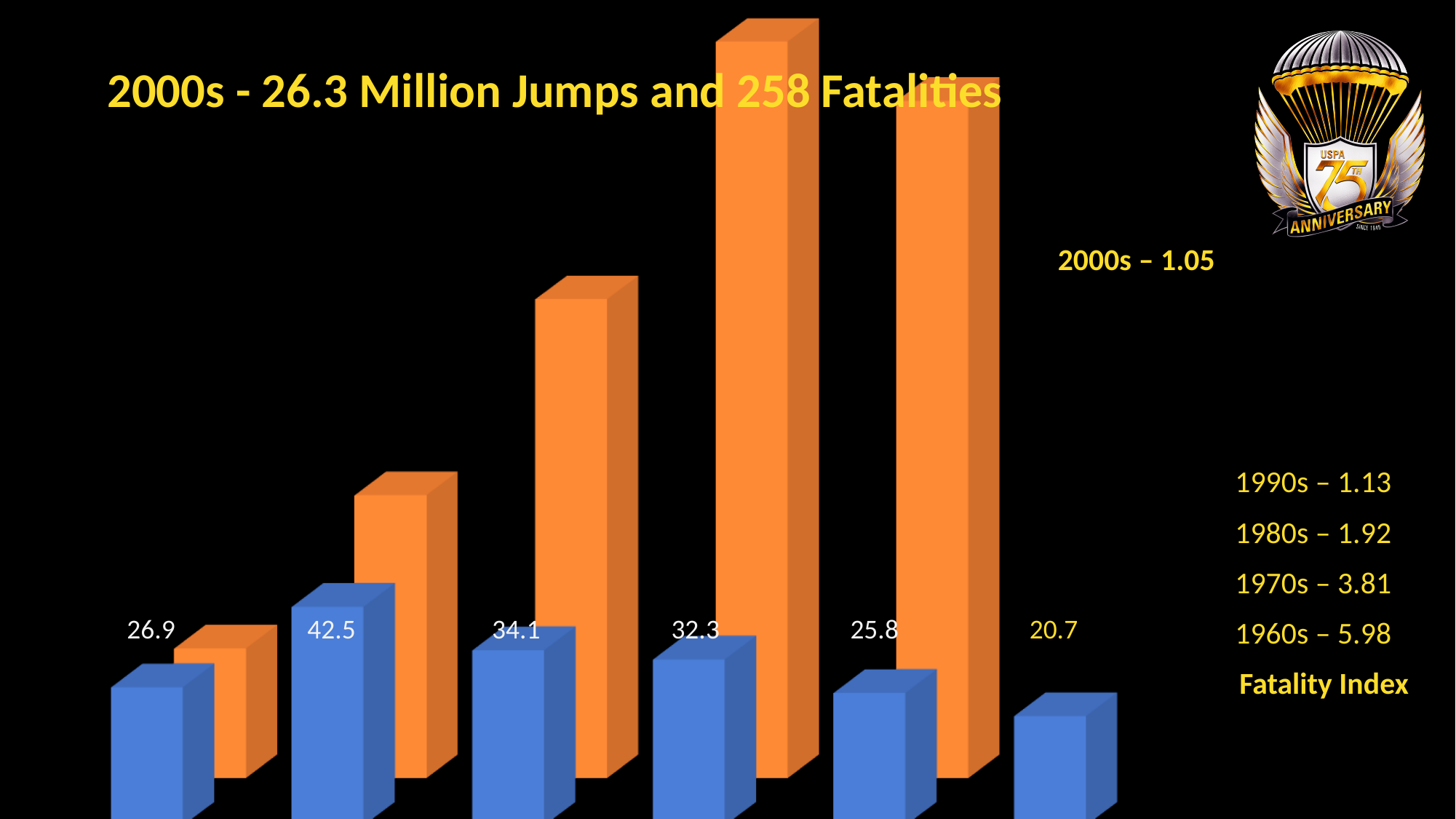
What is the title of the slide's chart? 2000s - 26.3 Million Jumps and 258 Fatalities What kind of chart is shown on the slide? bar chart What is the difference between the labelled values of the second blue bar (42.5) and the rightmost blue bar (20.7)? 21.8 Which blue bar has the lowest labelled value? the rightmost (20.7) What value is labelled on the second blue bar from the left? 42.5 Which is larger, the labelled value of the third blue bar (34.1) or the fourth blue bar (32.3)? 34.1 Do the labelled blue bar values rise or fall from the second bar to the rightmost bar? fall How many blue bars are plotted in the chart? 6 What value is labelled on the first blue bar from the left? 26.9 Which blue bar has the highest labelled value? the second from the left (42.5) What value is labelled on the rightmost blue bar? 20.7 Which orange bar is the tallest? the fourth from the left